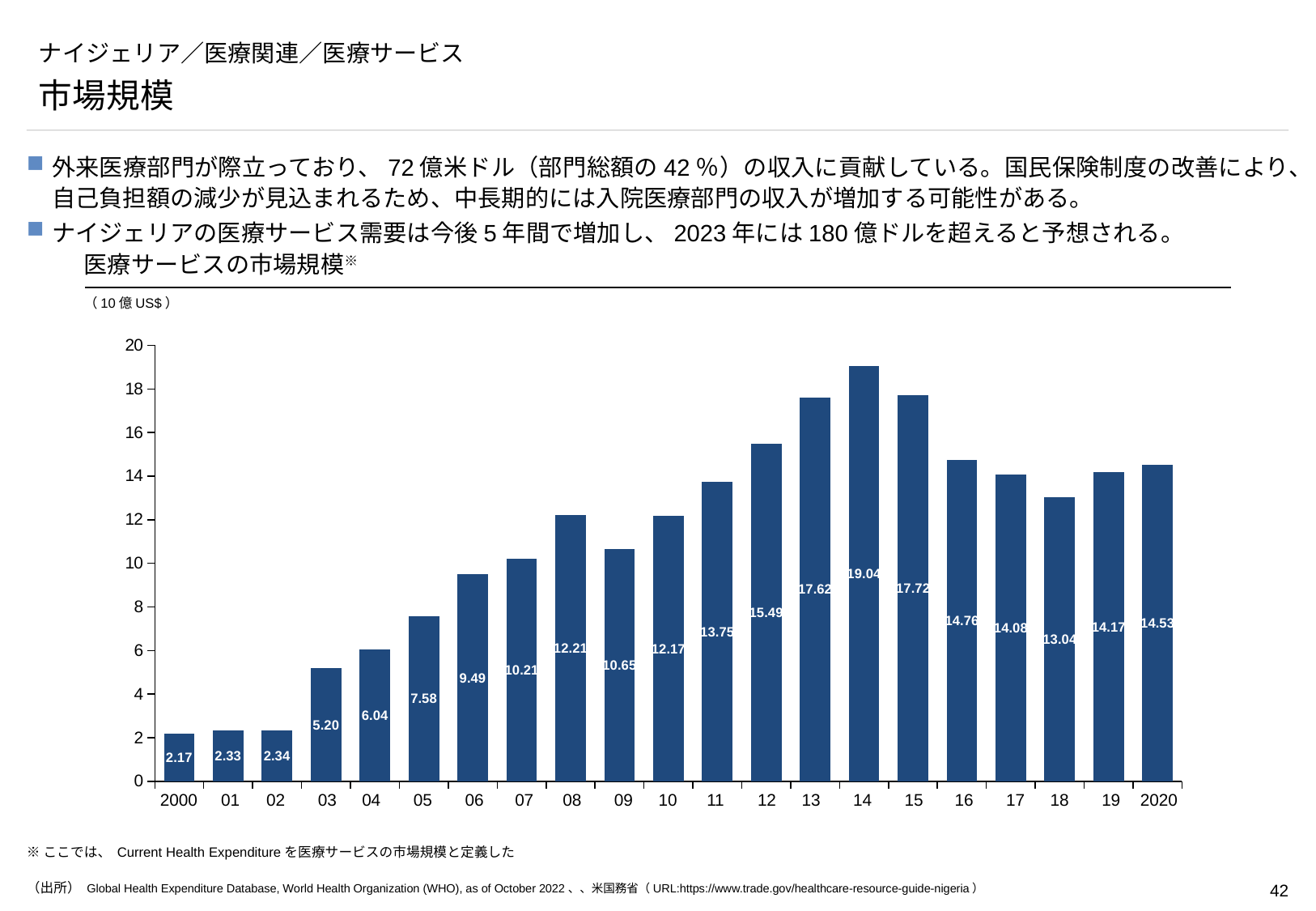
What type of chart is shown on the slide? bar chart Is the value for 2014 greater or less than 18? greater What is the value for 2000? 2.17 What is the value for 2009? 10.65 What is the difference between the values for 2020 and 2019? 0.36 What is the difference between the values for 2014 and 2000? 16.87 How many years are plotted on the chart? 21 Which year has the lowest value? 2000 What is the value for 2020? 14.53 Which is larger, the value for 2012 or the value for 2016? 2012 Which year has the highest value? 2014 What is the value for 2014? 19.04